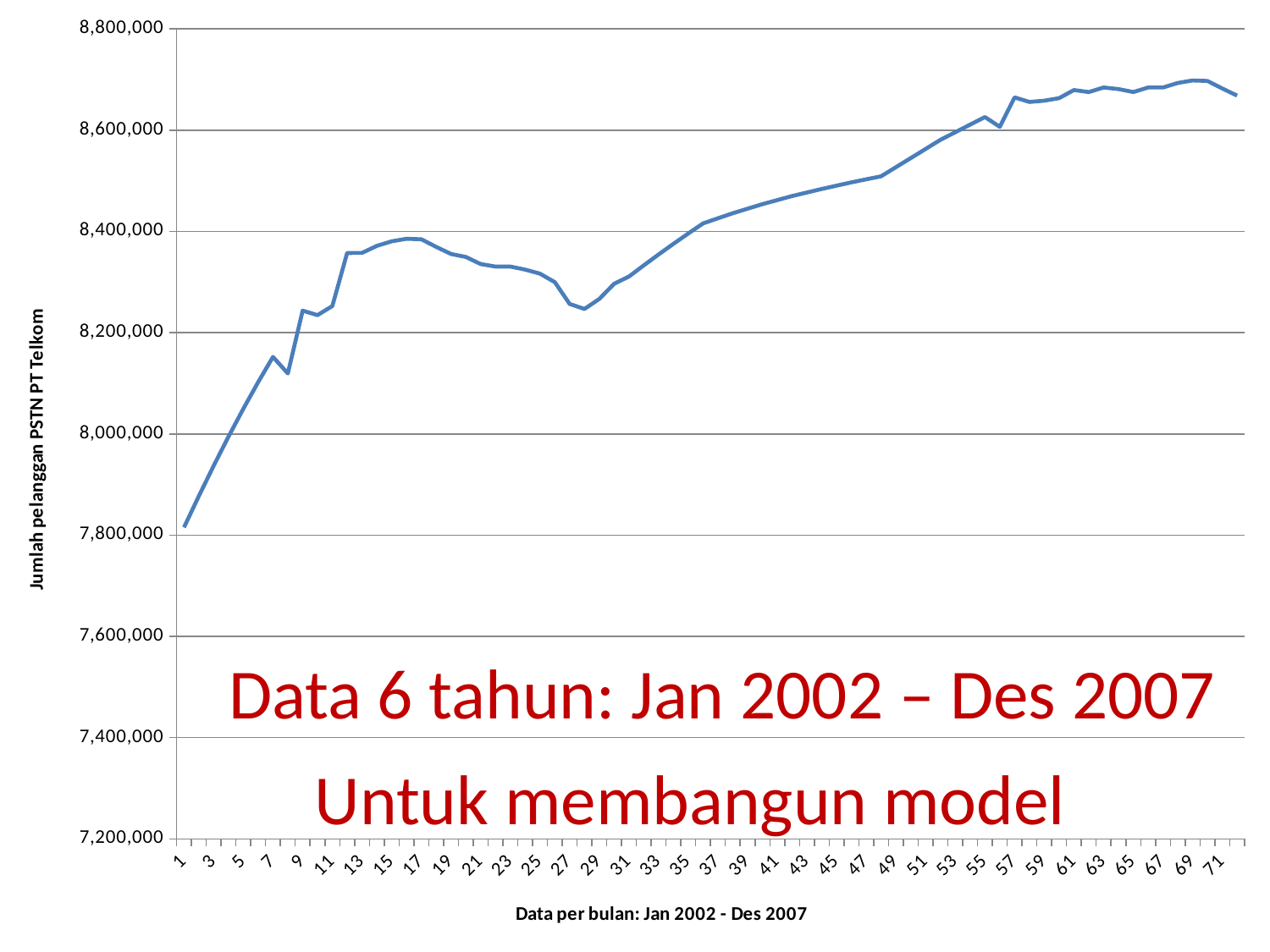
What is the title of the vertical axis? Jumlah pelanggan PSTN PT Telkom Is the value at x = 13 greater or less than 8,200,000? greater Which has the larger value, x = 1 or x = 71? 71 What kind of chart is shown on the slide? line chart What is the title of the horizontal axis? Data per bulan: Jan 2002 - Des 2007 Which has the larger value, x = 17 or x = 29? 17 Is the value at x = 1 greater or less than 8,000,000? less Is the value at x = 71 greater or less than 8,600,000? greater Overall, do the values rise or fall from left to right along the x axis? rise At which x-axis point is the plotted value lowest? 1